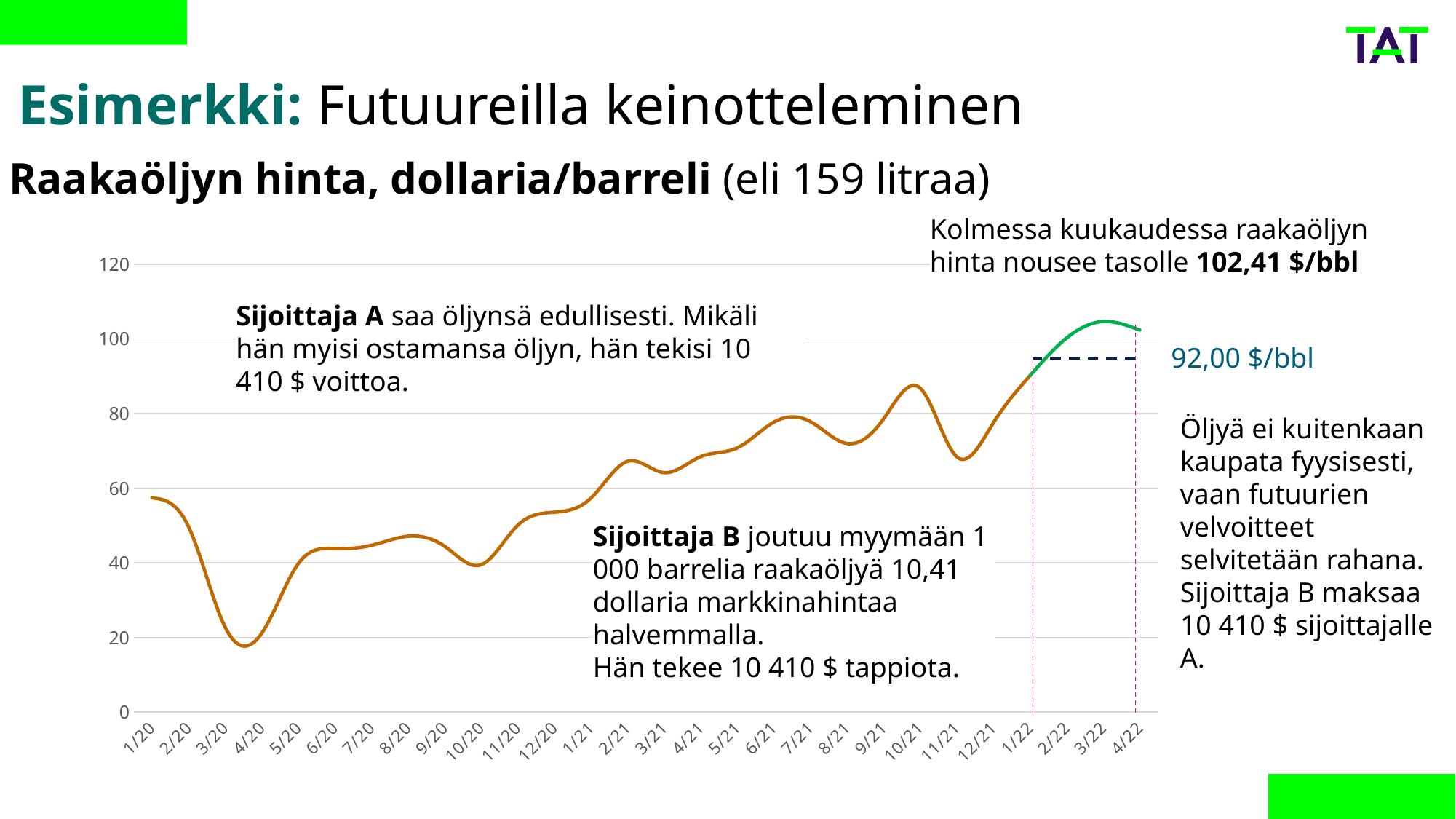
Is the value for 10/20 greater or less than 60? less What is the highest tick value shown on the y axis of the chart? 120 What kind of chart is shown on the slide? line chart Which is larger, the value for 1/20 or the value for 3/20? 1/20 Is the value for 1/20 greater or less than 40? greater Do the values rise or fall along the x axis from 11/21 to 3/22? rise What is the difference between the price at 4/22 (102,41 $/bbl) and the price at 1/22 (92,00 $/bbl)? 10,41 $/bbl How many month labels are shown on the x axis of the chart? 28 Is the value for 11/21 greater or less than 80? less Which is larger, the value for 10/21 or the value for 11/21? 10/21 What crude oil price is marked at 1/22 on the chart? 92,00 $/bbl What crude oil price level is reached at 4/22 according to the slide? 102,41 $/bbl